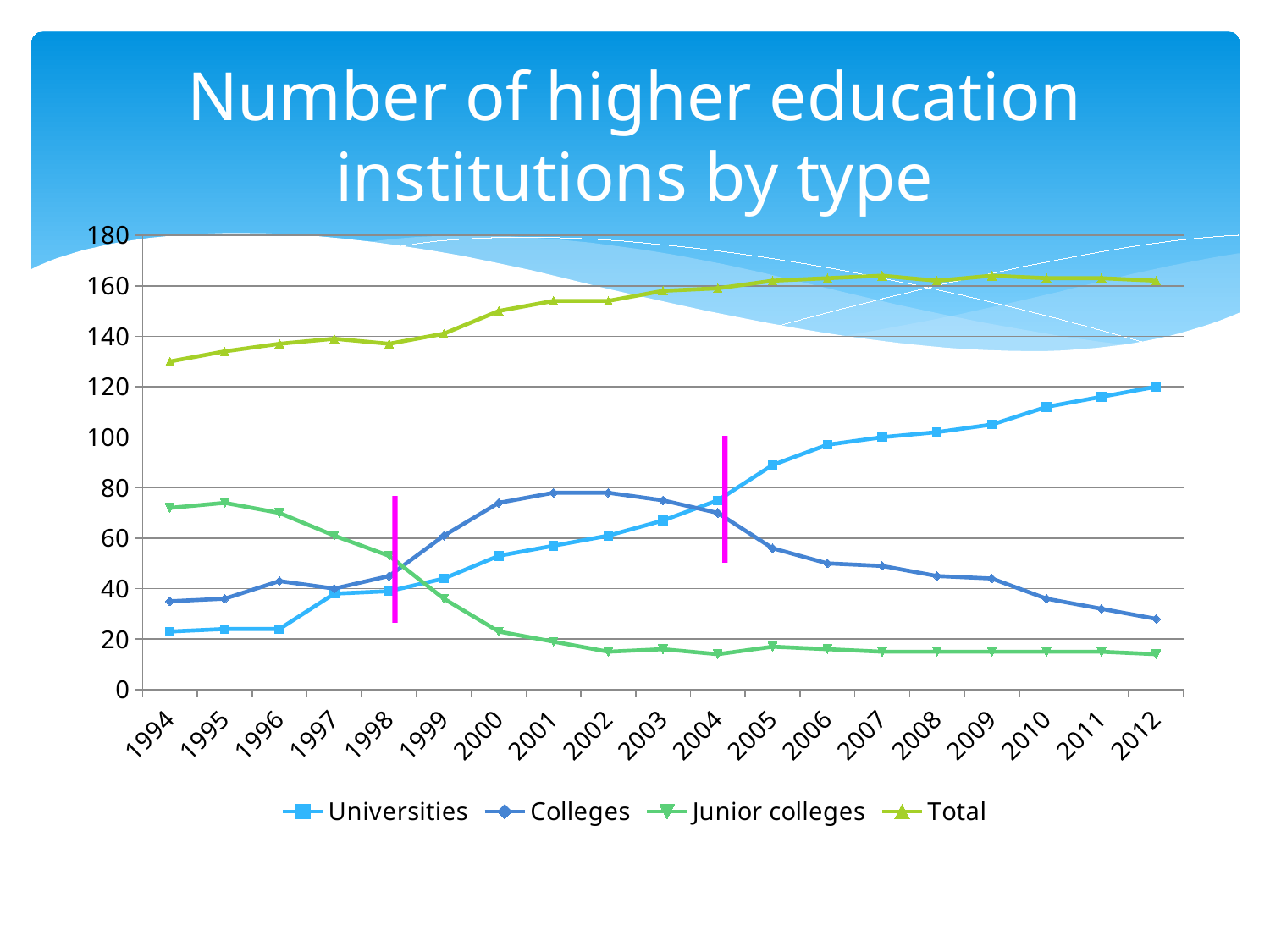
How many years are shown on the x axis? 19 Is the value for Junior colleges in 2012 greater or less than 20? less What kind of chart is shown on the slide? line chart Do the values for Junior colleges rise or fall from 1994 to 2012? fall How many series does the legend list? 4 Is the value for Total in 1994 greater or less than 120? greater Which series has the lowest value in 2012? Junior colleges Do the values for Universities rise or fall from 1994 to 2012? rise In 2001, which is larger: Colleges or Universities? Colleges In 2010, which is larger: Universities or Colleges? Universities What is the title of the chart? Number of higher education institutions by type Is the value for Universities in 1994 greater or less than 40? less